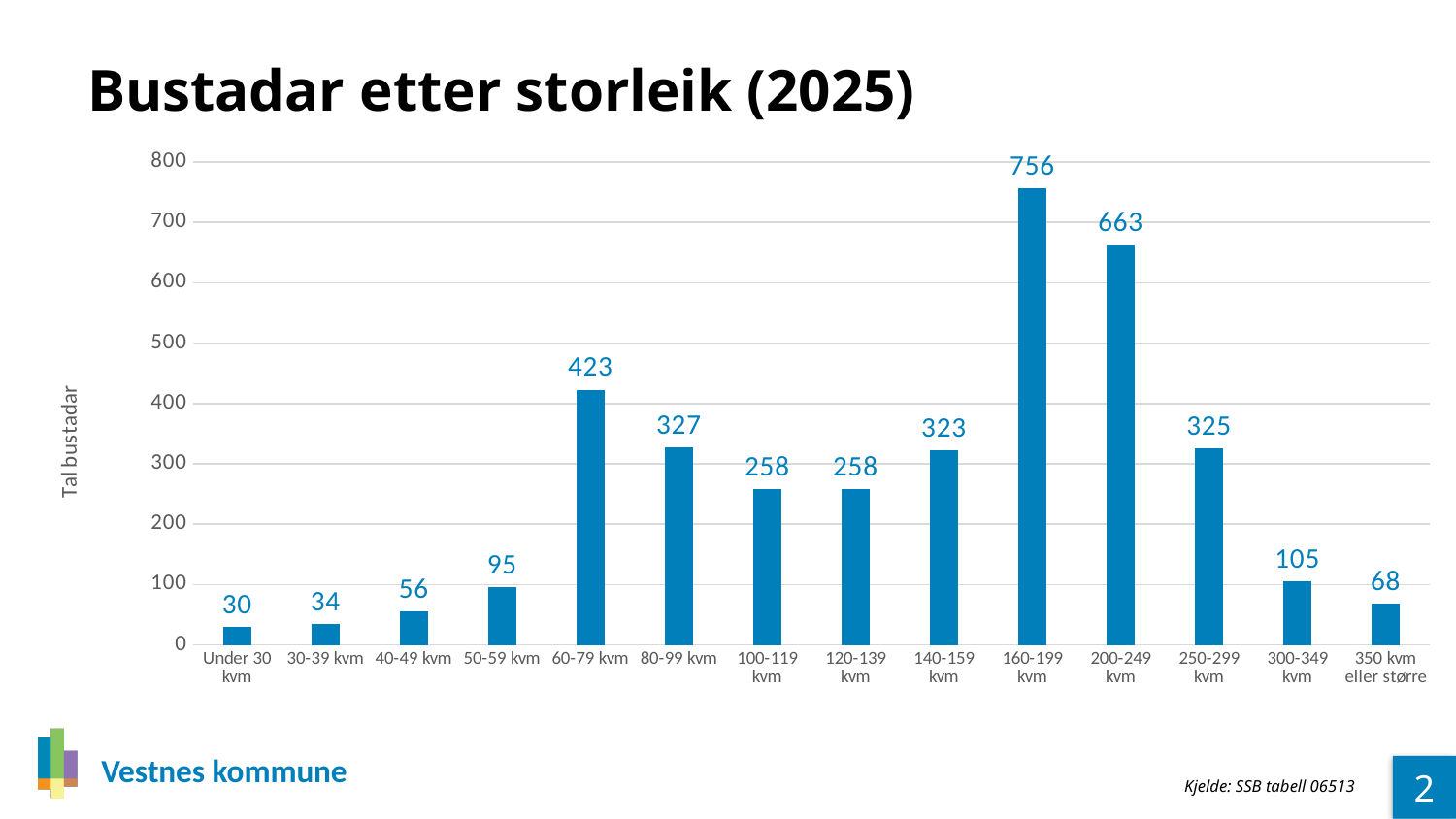
What is the label of the y axis? Tal bustadar What is the title of the chart? Bustadar etter storleik (2025) Is the value for 300-349 kvm greater or less than 200? less What is the value for 160-199 kvm? 756 What kind of chart is shown on the slide? bar chart Which category has the lowest value? Under 30 kvm Which category has the highest value? 160-199 kvm What is the value for 60-79 kvm? 423 What is the value for 350 kvm eller større? 68 How many categories are shown on the x axis? 14 What is the difference between the values for 160-199 kvm and 200-249 kvm? 93 Which is larger, the value for 80-99 kvm or the value for 250-299 kvm? 80-99 kvm